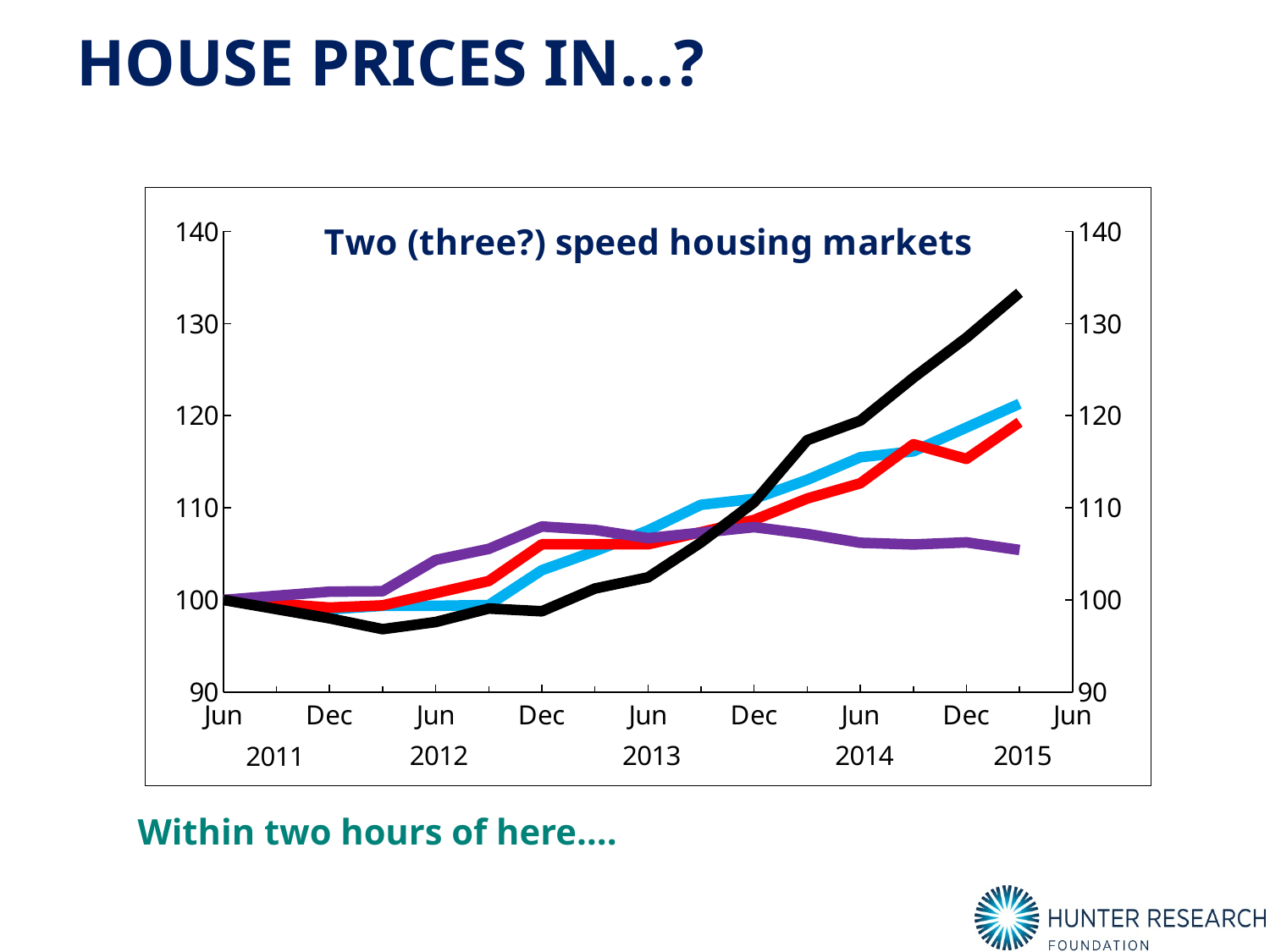
Is the final value of the black line greater or less than 130? greater What kind of chart is shown on the slide? line chart Does the black line rise or fall between Dec 2013 and its end in 2015? rise Does the purple line rise or fall between Dec 2013 and its end in 2015? fall What is the title printed inside the chart? Two (three?) speed housing markets Is the final value of the blue line greater or less than 120? greater At the end of the series in 2015, is the black line or the red line higher? the black line How many lines are plotted on the chart? 4 Which line ends highest in 2015? the black line Is the final value of the purple line greater or less than 110? less Which line ends lowest in 2015? the purple line What is the lowest value shown on the vertical axis? 90